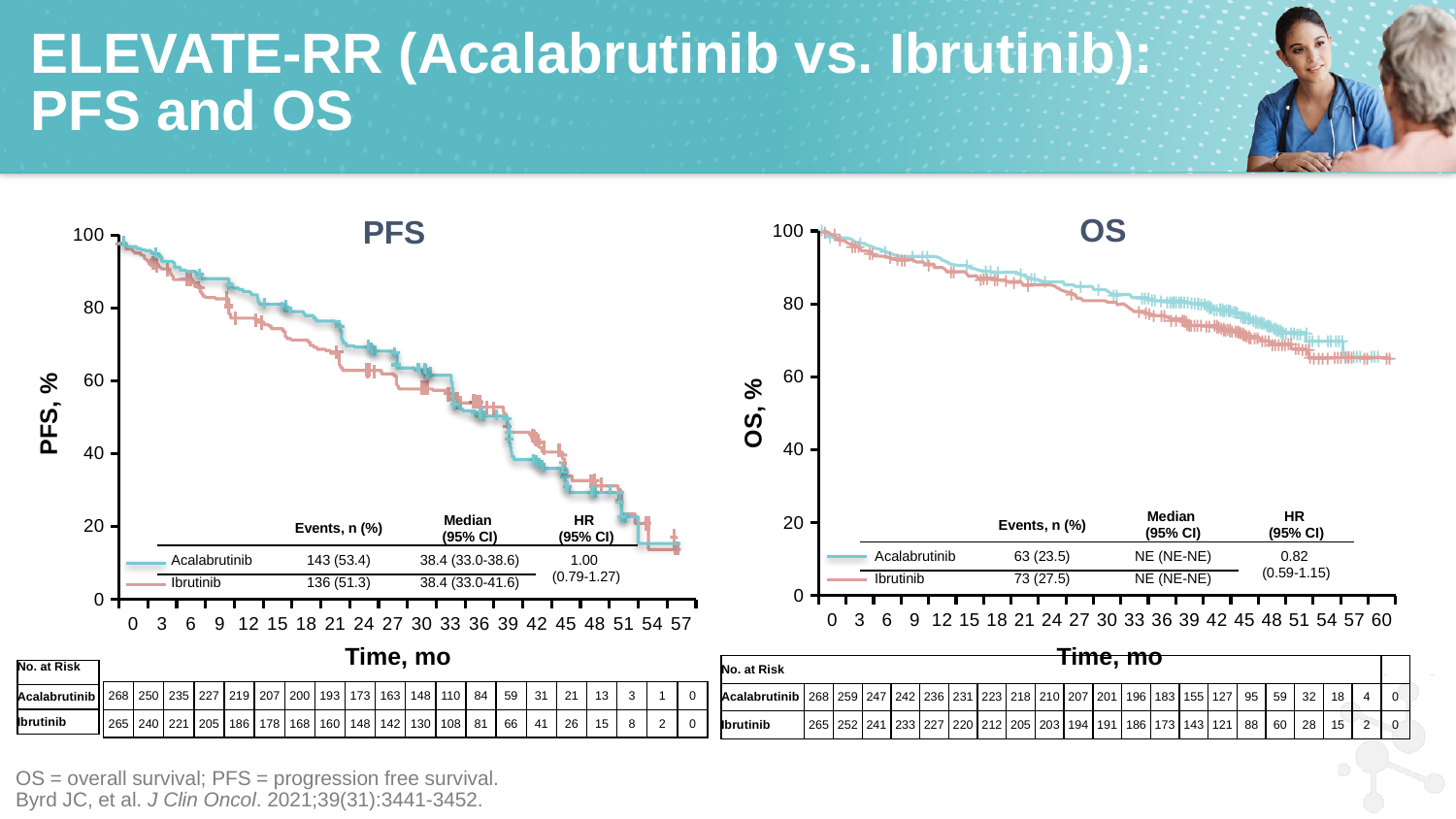
In the PFS chart, is the PFS value for Ibrutinib at 48 months greater or less than 40? less How many series does the legend of the OS chart list? 2 In the PFS chart, what is the median PFS (95% CI) for Ibrutinib? 38.4 (33.0-41.6) In the OS chart, what is the HR (95% CI) shown in the legend? 0.82 (0.59-1.15) In the PFS chart, what is the median PFS (95% CI) for Acalabrutinib? 38.4 (33.0-38.6) In the PFS chart, which arm has more events: Acalabrutinib or Ibrutinib? Acalabrutinib In the PFS chart, what is the HR (95% CI) shown in the legend? 1.00 (0.79-1.27) What kind of chart is the PFS chart? Line chart (Kaplan-Meier curves) In the PFS chart, what is the difference in the number of events between Acalabrutinib (143) and Ibrutinib (136)? 7 In the OS chart, is the OS value for Acalabrutinib at 24 months greater or less than 60? greater In the OS chart, how many events, n (%), are reported for Acalabrutinib? 63 (23.5) In the PFS chart, do the PFS curves rise or fall as time increases along the x axis? fall